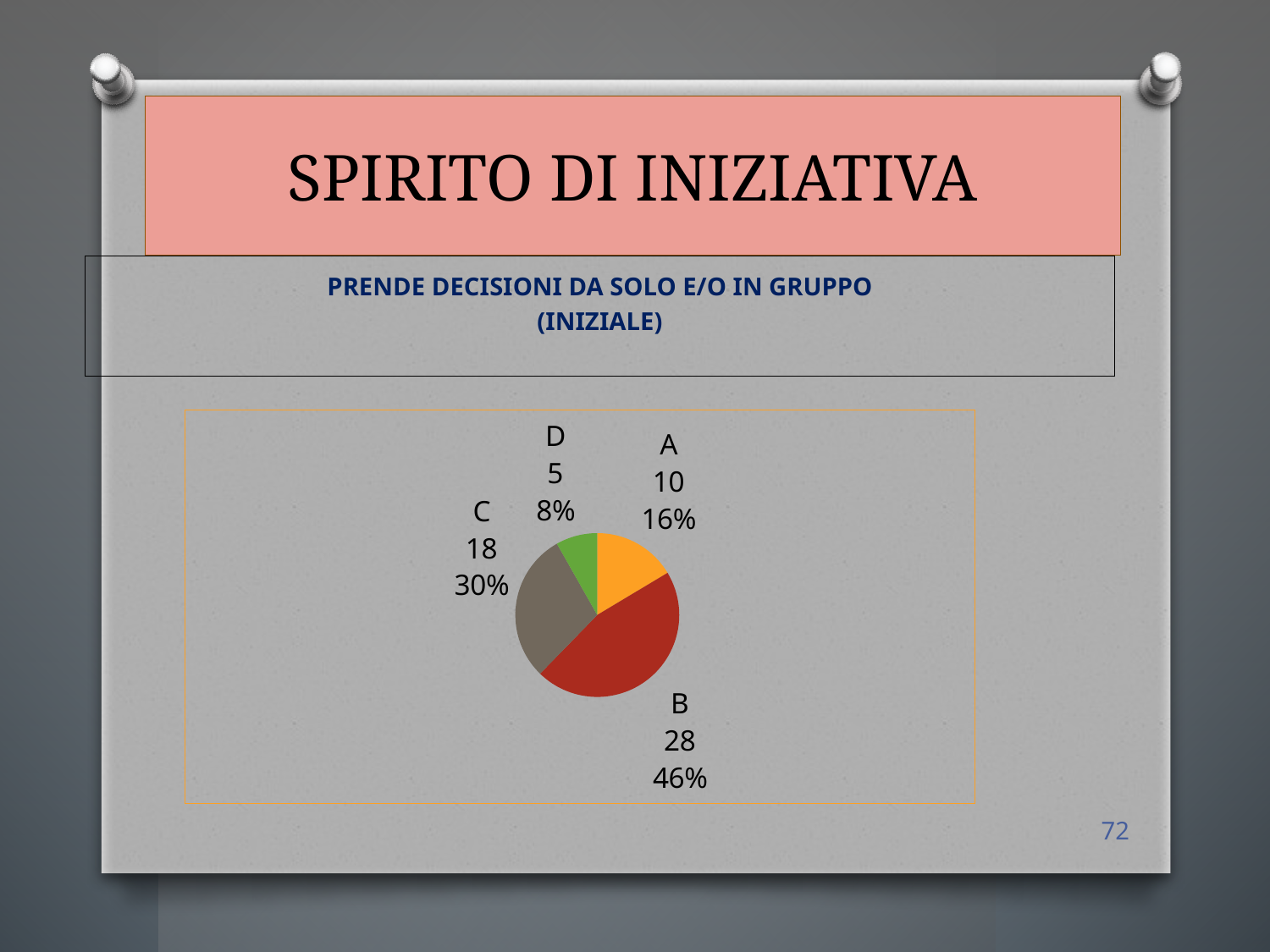
Which category has the smallest slice? D What is the total of all the values in the pie chart? 61 What is the value for category B? 28 What is the difference between the values for B and C? 10 What percentage share does category A have? 16% Which is larger, the value for A or the value for C? C What percentage share does category C have? 30% How many categories are shown in the pie chart? 4 What is the value for category D? 5 Which category has the largest slice? B What is the title of the slide? SPIRITO DI INIZIATIVA What kind of chart is shown on the slide? pie chart